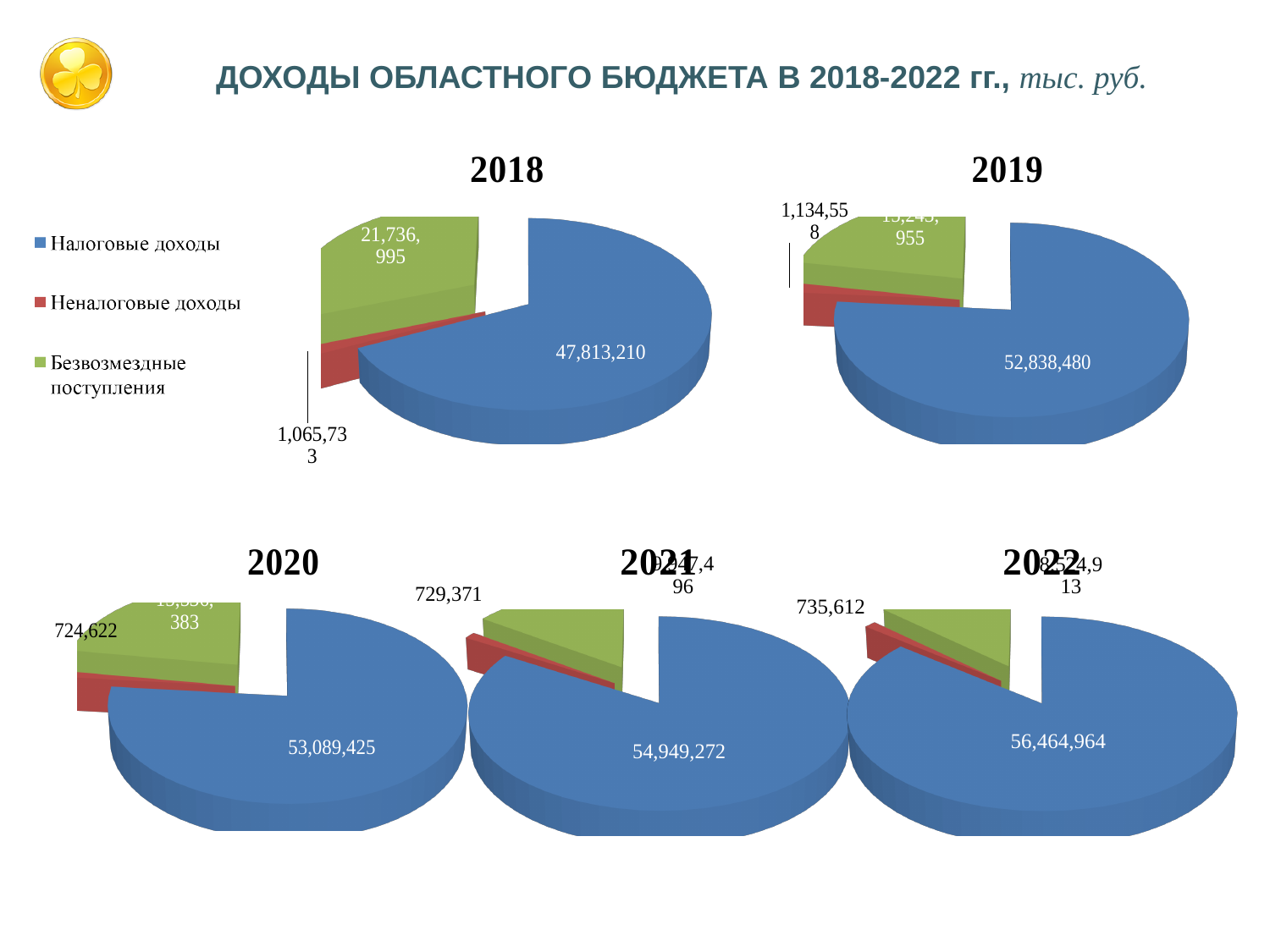
Does the value for Налоговые доходы rise or fall from the 2018 chart to the 2022 chart? Rises How many series does the legend list? 3 In the 2022 chart, what is the value for Налоговые доходы? 56,464,964 In the 2018 chart, what is the difference between Налоговые доходы and Безвозмездные поступления? 26,076,215 In the 2018 chart, which category has the smallest slice? Неналоговые доходы How many pie charts are on the slide? 5 In the 2018 chart, what is the value for Безвозмездные поступления? 21,736,995 In the 2020 chart, what is the value for Неналоговые доходы? 724,622 In the 2021 chart, which category has the largest slice? Налоговые доходы In the 2018 chart, what is the value for Налоговые доходы? 47,813,210 What kind of charts are shown on the slide? Pie charts In the 2019 chart, what is the value for Налоговые доходы? 52,838,480